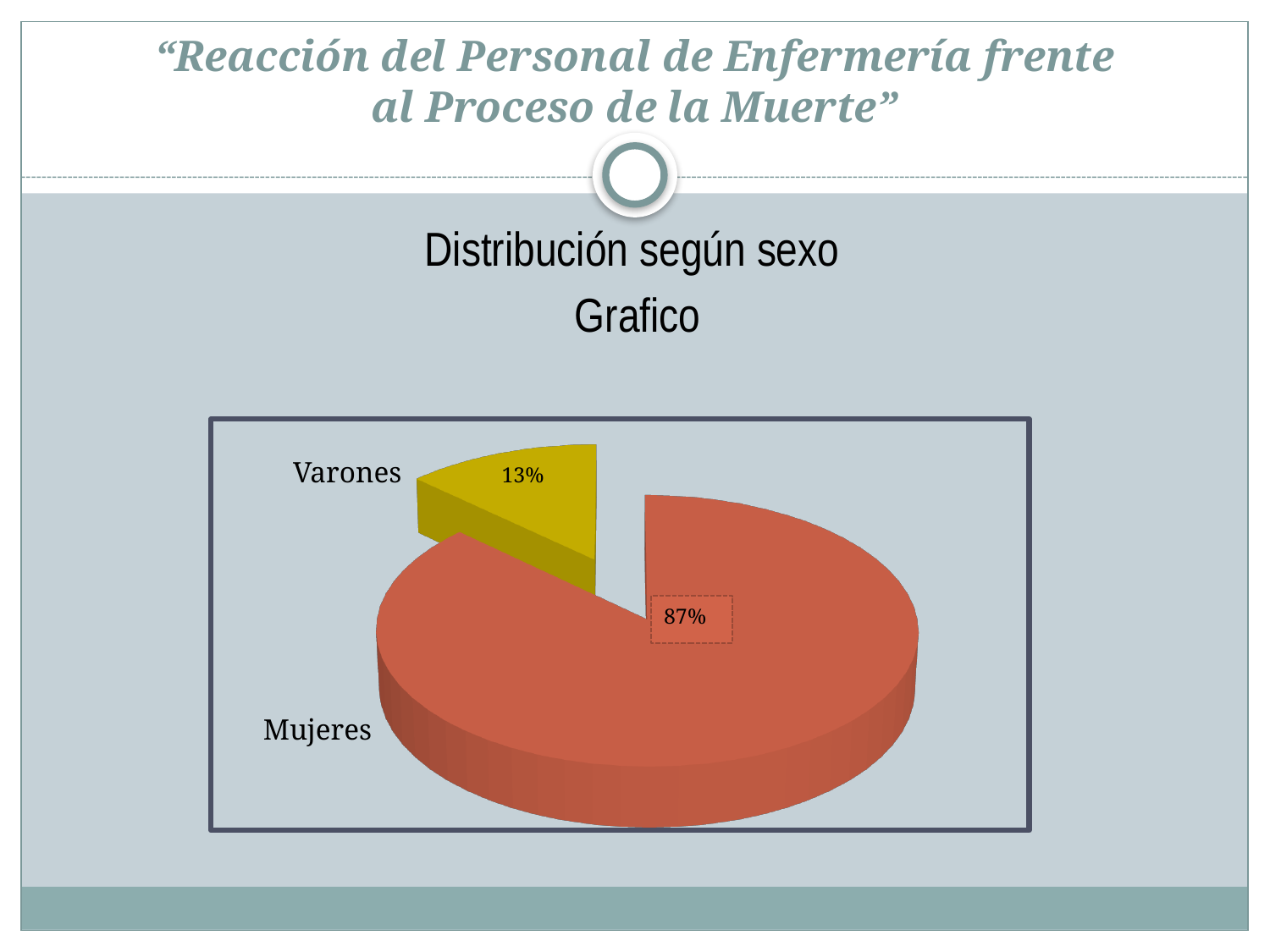
Which category has the largest slice of the pie? Mujeres What share of the pie does Mujeres represent? 87% What kind of chart is shown on the slide? pie chart What is the title shown above the chart? Distribución según sexo What is the difference in percentage points between Mujeres and Varones? 74 Which category has the smallest slice of the pie? Varones Is the share for Varones greater or less than 50%? less What share of the pie does Varones represent? 13% What colour is the Varones slice? yellow How many categories are shown in the pie chart? 2 Which is larger, the share for Mujeres or the share for Varones? Mujeres